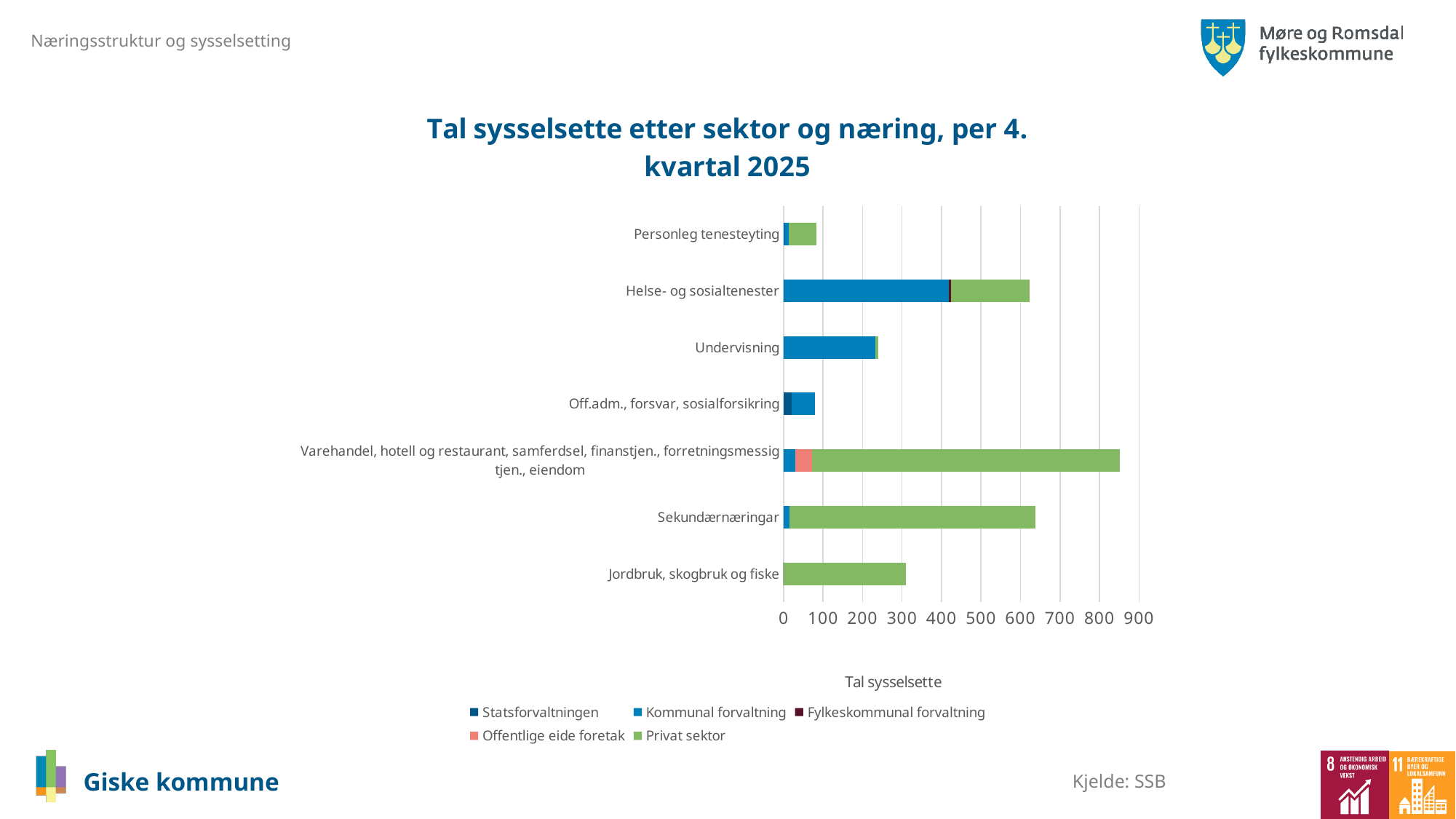
How many categories (næringar) are shown on the y axis of the chart? 7 Is the total value for Undervisning greater or less than 300? less Is the total value for Off.adm., forsvar, sosialforsikring greater or less than 100? less What is the title of the chart? Tal sysselsette etter sektor og næring, per 4. kvartal 2025 How many series does the legend list? 5 Which has the larger total bar: Helse- og sosialtenester or Jordbruk, skogbruk og fiske? Helse- og sosialtenester Is the total value for Jordbruk, skogbruk og fiske greater or less than 200? greater What kind of chart is shown on the slide? bar chart Which colour represents Privat sektor in the legend? green Which category has the longest total bar? Varehandel, hotell og restaurant, samferdsel, finanstjen., forretningsmessig tjen., eiendom